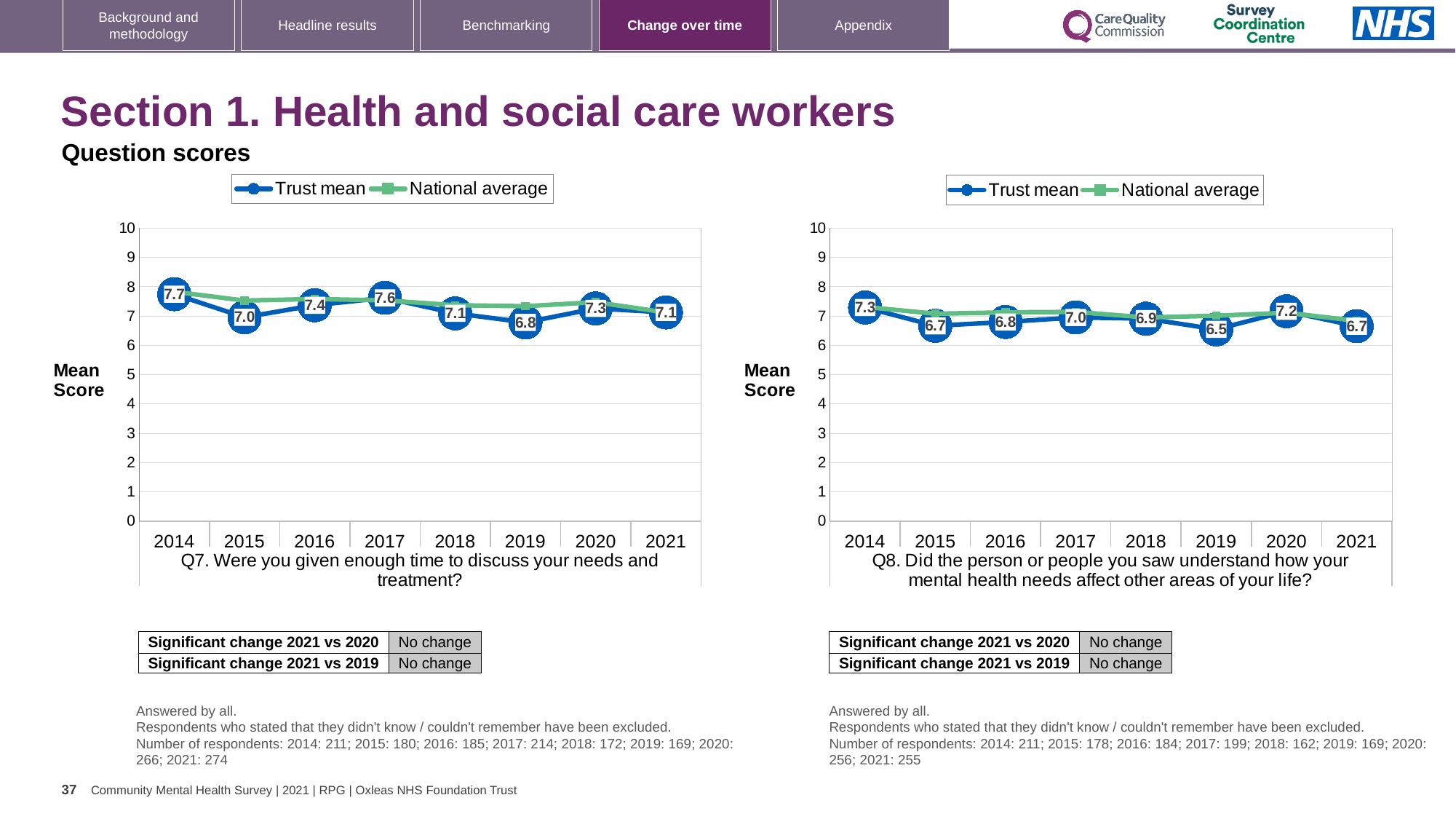
In the Q8 chart, what is the Trust mean for 2020? 7.2 In the Q8 chart, is the Trust mean higher in 2017 or in 2019? 2017 In the Q7 chart, what is the Trust mean for 2019? 6.8 What type of chart is used for Q7? Line chart In the Q7 chart, which year has the lowest Trust mean? 2019 In the Q7 chart, which year has the highest Trust mean? 2014 How many series does the legend of the Q7 chart list? 2 In the Q8 chart, which year has the lowest Trust mean? 2019 In the Q8 chart, what is the Trust mean for 2021? 6.7 In the Q7 chart, what is the Trust mean for 2014? 7.7 How many years are plotted on the x axis of the Q8 chart? 8 In the Q7 chart, what is the difference between the Trust mean in 2014 and in 2015? 0.7